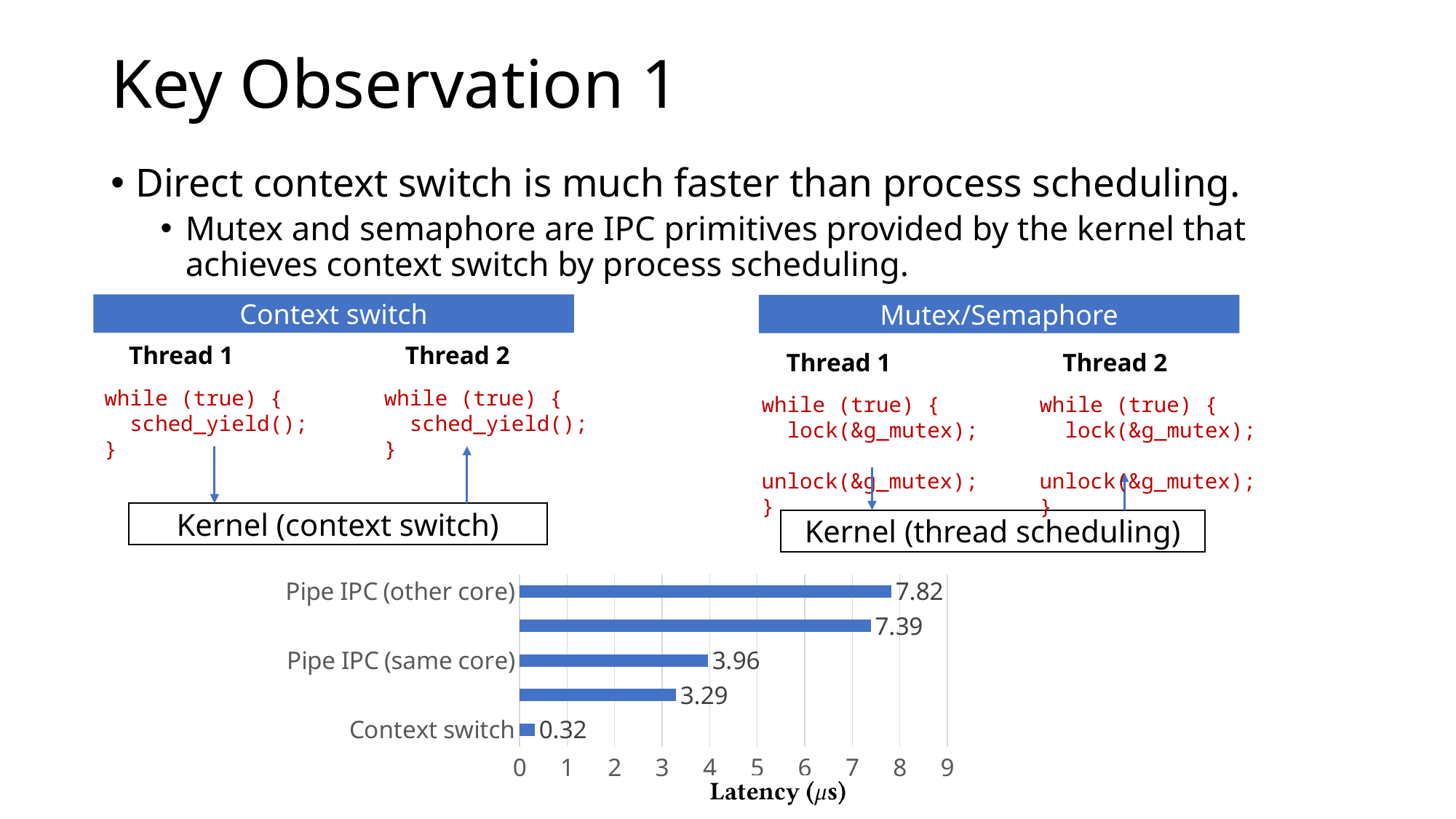
What is the difference in latency between Pipe IPC (same core) and Context switch? 3.64 Is the latency for Pipe IPC (other core) greater or less than 7? greater Which has a larger latency, Pipe IPC (same core) or Context switch? Pipe IPC (same core) Which labeled category has the highest latency? Pipe IPC (other core) What is the difference in latency between Pipe IPC (other core) and Pipe IPC (same core)? 3.86 What kind of chart is shown on the slide? Bar chart How many bars are plotted in the chart? 5 What is the latency for Pipe IPC (other core)? 7.82 What is the label of the horizontal axis of the chart? Latency (μs) What is the latency for Context switch? 0.32 Which labeled category has the lowest latency? Context switch What is the latency for Pipe IPC (same core)? 3.96